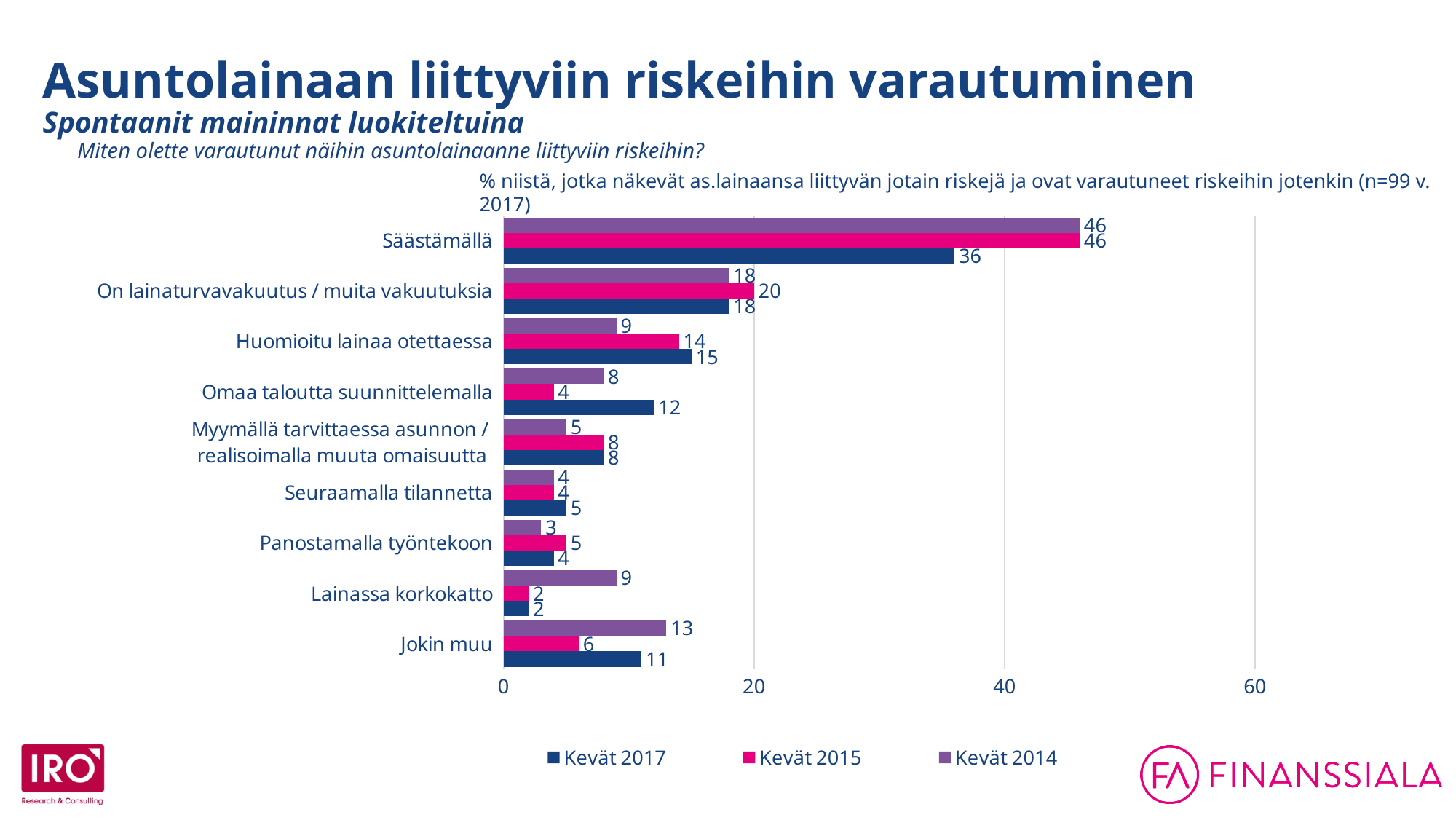
What kind of chart is shown on the slide? Bar chart What is the value for Jokin muu in the Kevät 2014 series? 13 Which category has the highest value in the Kevät 2017 series? Säästämällä What is the value for On lainaturvavakuutus / muita vakuutuksia in the Kevät 2015 series? 20 Which category has the lowest value in the Kevät 2017 series? Lainassa korkokatto What is the value for Säästämällä in the Kevät 2017 series? 36 What is the difference between the Kevät 2014 and Kevät 2017 values for Säästämällä? 10 How many series does the legend list? 3 Which is larger for Omaa taloutta suunnittelemalla: the Kevät 2017 value or the Kevät 2015 value? Kevät 2017 Which series is shown in pink in the legend? Kevät 2015 How many categories are shown on the chart? 9 What is the value for Lainassa korkokatto in the Kevät 2014 series? 9